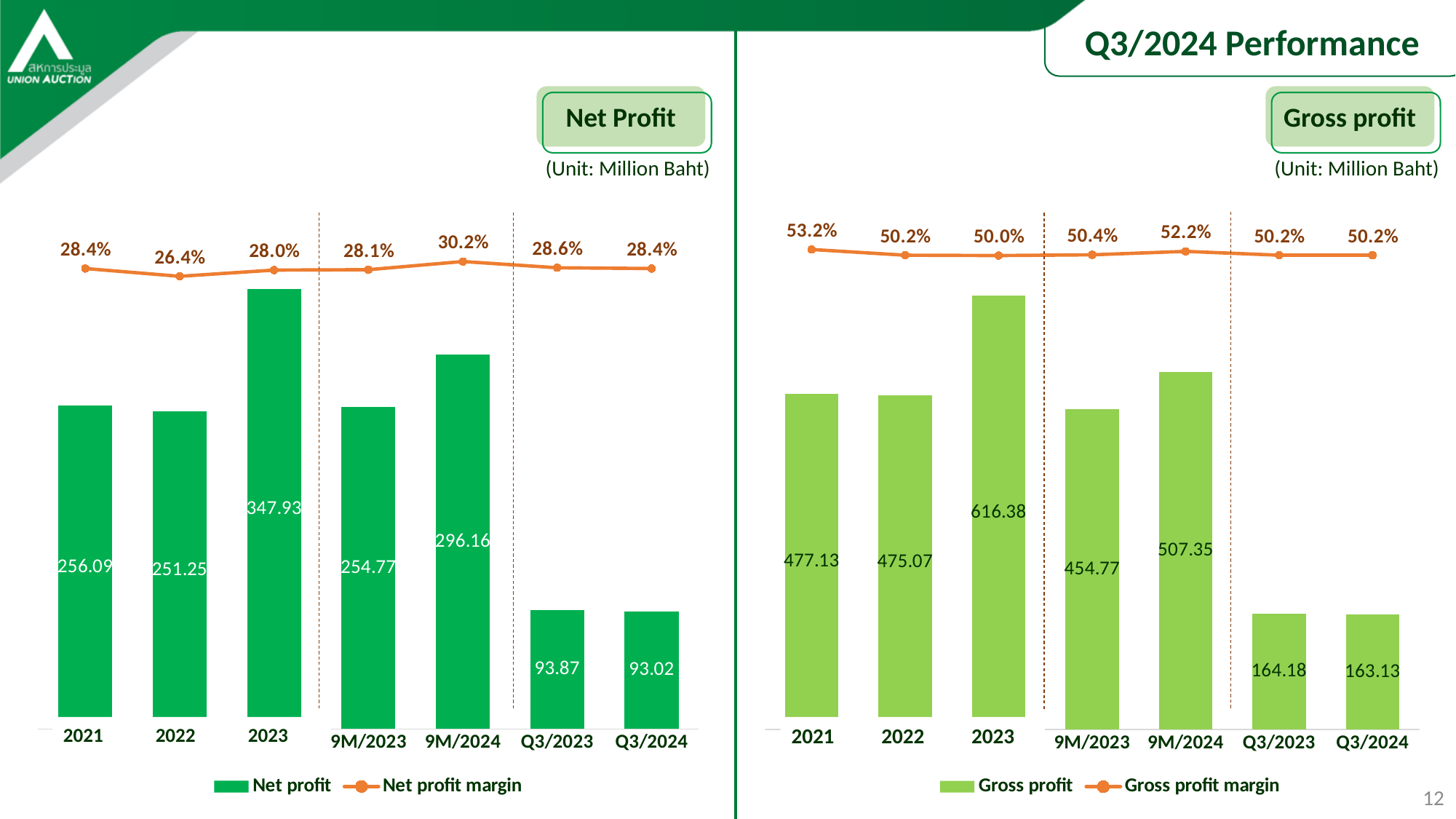
In the Gross profit chart, what is the gross profit for Q3/2024? 163.13 In the Net Profit chart, which is larger, the net profit for 2021 or 2022? 2021 How many series does the legend of the Net Profit chart list? 2 What kind of chart is the Gross profit chart? Combined bar and line chart In the Net Profit chart, which period has the highest net profit? 2023 In the Gross profit chart, what is the difference in gross profit between 2023 and 2022? 141.31 In the Net Profit chart, what is the net profit margin for 9M/2024? 30.2% In the Net Profit chart, what is the net profit for 2023? 347.93 In the Net Profit chart, what is the difference in net profit between 9M/2024 and 9M/2023? 41.39 In the Gross profit chart, what is the gross profit margin for 2021? 53.2% In the Gross profit chart, which period has the lowest gross profit? Q3/2024 How many periods are shown on the x axis of the Gross profit chart? 7